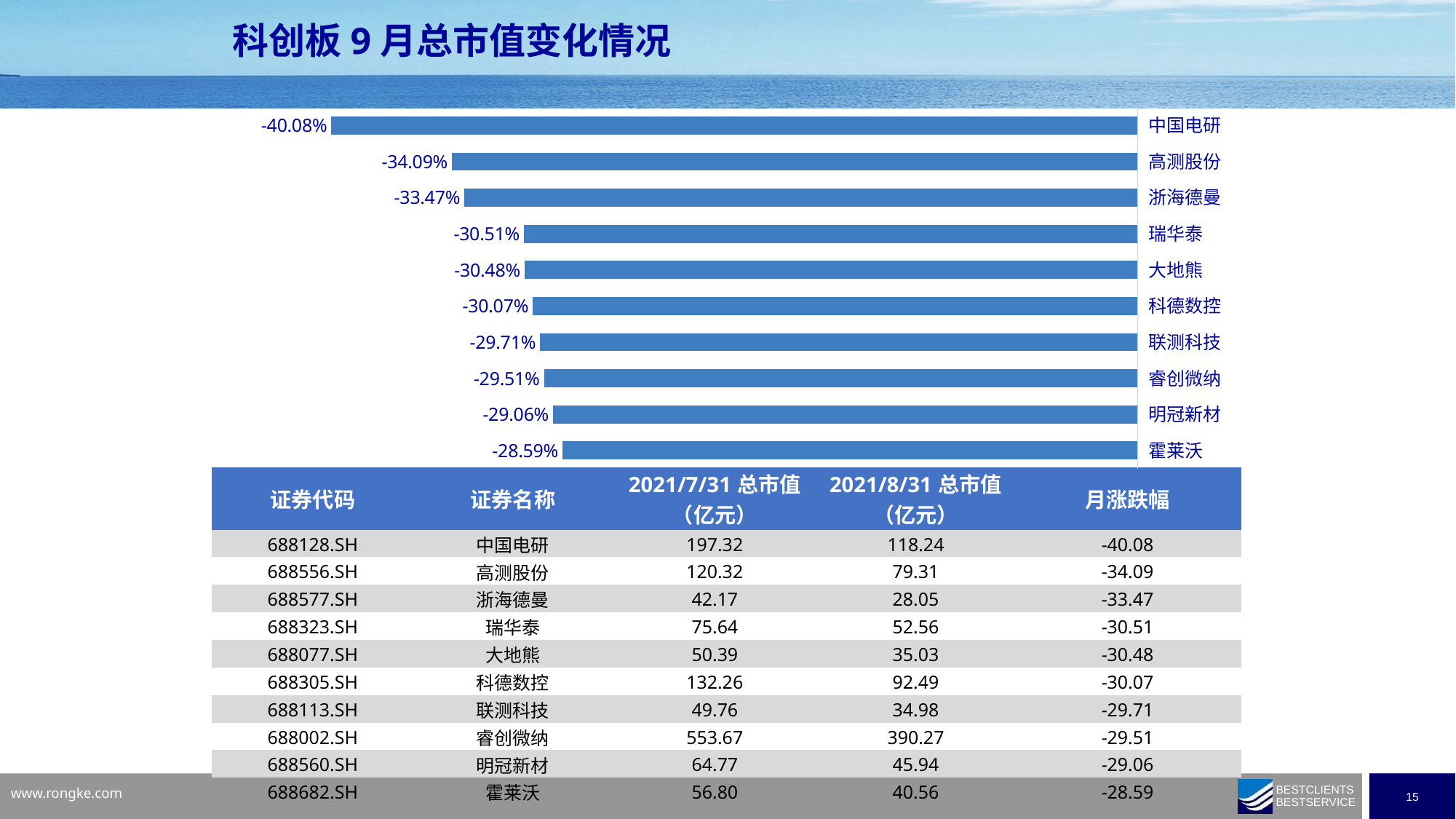
What is the value shown for 霍莱沃 in the bar chart? -28.59% What is the title of the slide containing the chart? 科创板 9 月总市值变化情况 What is the difference between the values for 中国电研 and 高测股份 in the bar chart? 5.99 percentage points What kind of chart is shown on the slide? Bar chart What is the value shown for 睿创微纳 in the bar chart? -29.51% Which category in the bar chart has the highest (least negative) value? 霍莱沃 Do the bar values become more negative or less negative going from the top bar to the bottom bar? Less negative Which category in the bar chart has the lowest (most negative) value? 中国电研 What is the value shown for 科德数控 in the bar chart? -30.07% What is the value shown for 中国电研 in the bar chart? -40.08% How many categories are plotted in the bar chart? 10 Which has the larger (less negative) value in the bar chart, 高测股份 or 霍莱沃? 霍莱沃